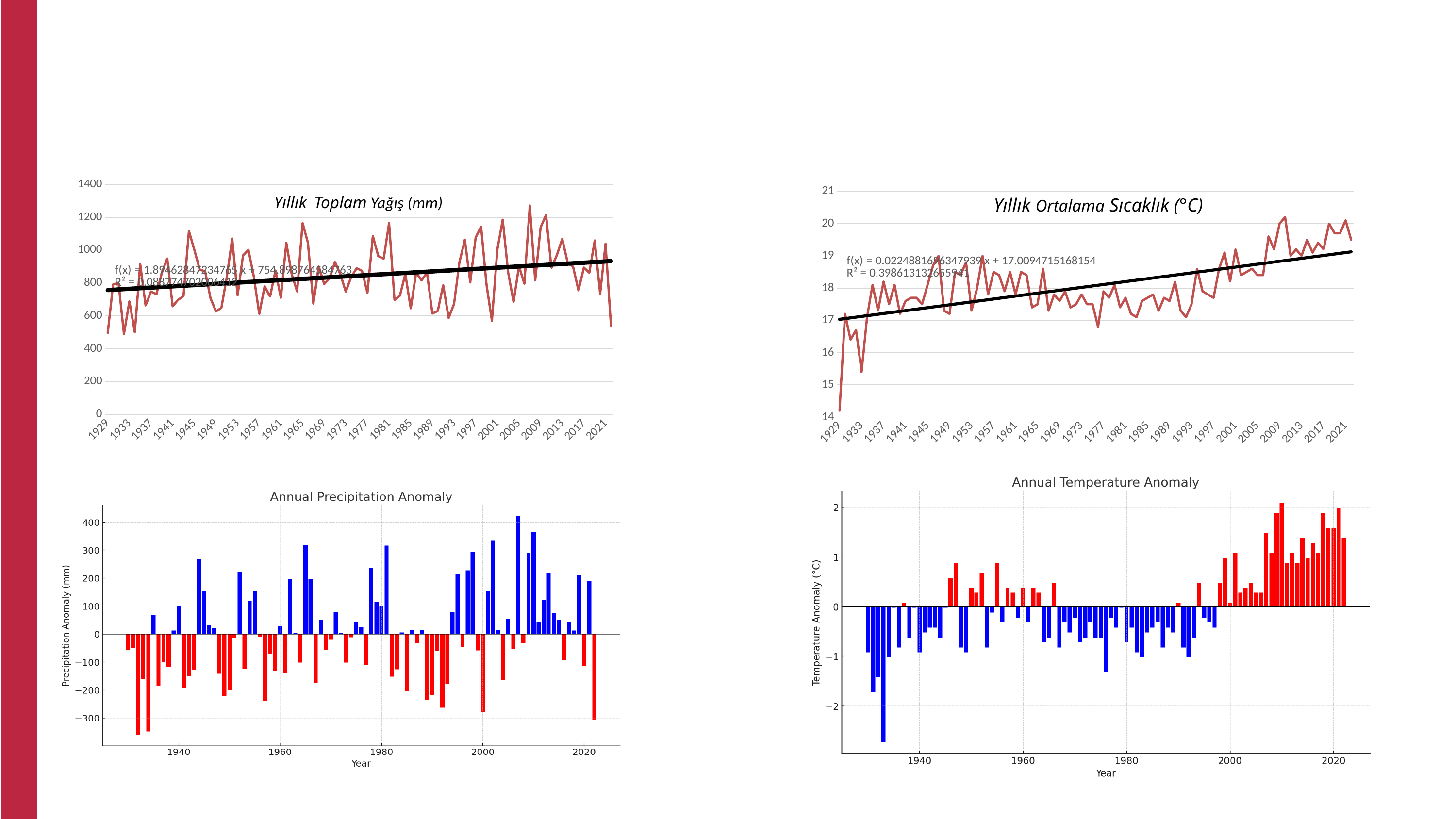
What kind of chart is the 'Yıllık Ortalama Sıcaklık (°C)' chart at the top right of the slide? line chart In the 'Yıllık Ortalama Sıcaklık (°C)' chart, is the value for 2021 greater or less than 19? greater What kind of chart is the 'Annual Precipitation Anomaly' chart at the bottom left of the slide? bar chart In the 'Annual Temperature Anomaly' chart, is the value for 2010 greater or less than 1? greater What is the y-axis label of the 'Annual Temperature Anomaly' chart at the bottom right of the slide? Temperature Anomaly (°C) In the 'Yıllık Toplam Yağış (mm)' chart, does the black trend line rise or fall from left to right? rise In the 'Annual Precipitation Anomaly' chart, what colour are the bars with negative values? red In the 'Yıllık Ortalama Sıcaklık (°C)' chart, do the values generally rise or fall from 1929 to 2021? rise In the 'Yıllık Toplam Yağış (mm)' chart, is the value for 1929 greater or less than 600? less